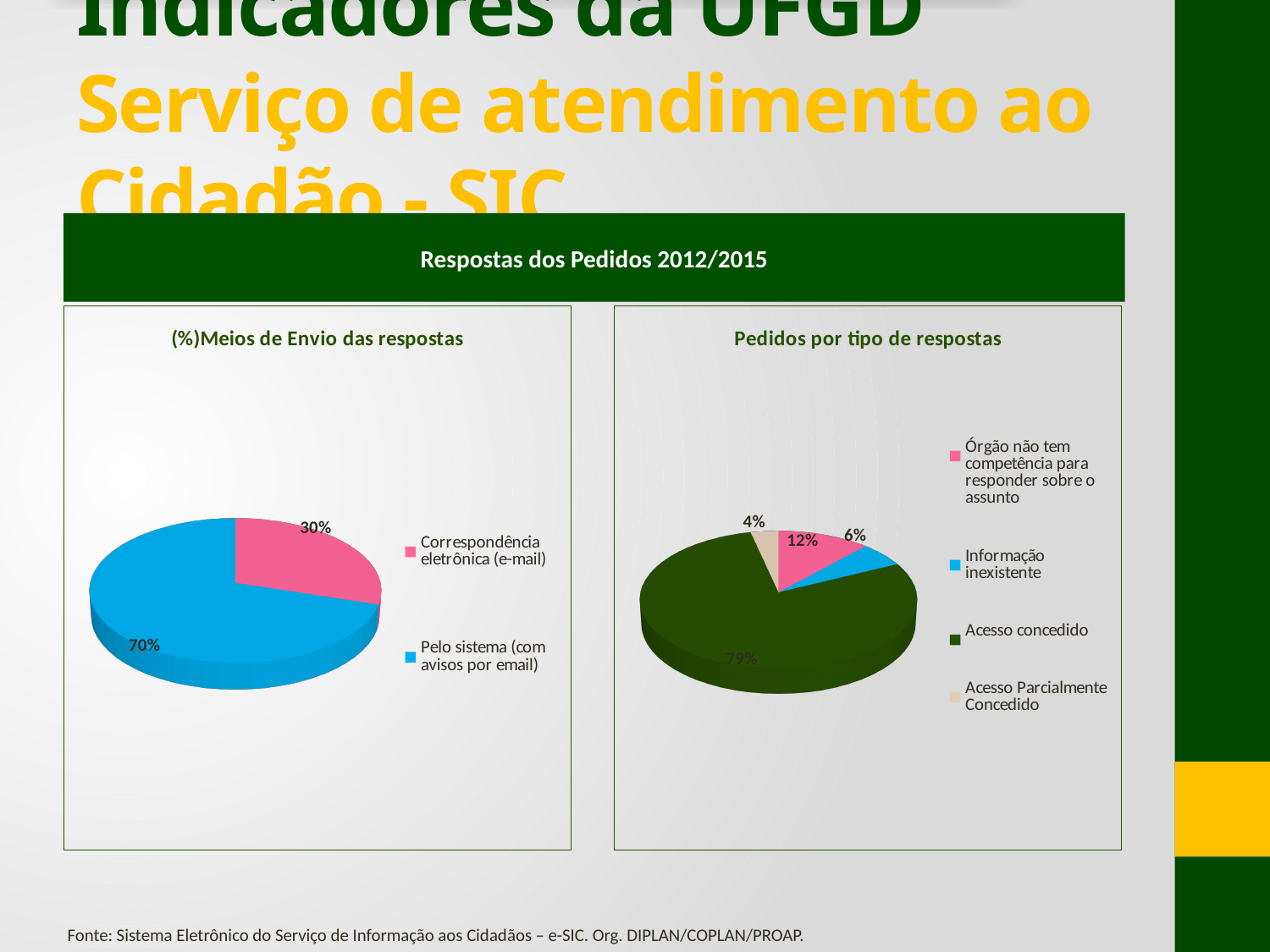
In the chart titled "Pedidos por tipo de respostas", which category has the smallest share? Acesso Parcialmente Concedido In the chart titled "Pedidos por tipo de respostas", what is the value for "Acesso concedido"? 79% In the chart titled "(%)Meios de Envio das respostas", how many categories does the legend list? 2 In the chart titled "(%)Meios de Envio das respostas", what is the value for "Pelo sistema (com avisos por email)"? 70% In the chart titled "Pedidos por tipo de respostas", which is larger: "Órgão não tem competência para responder sobre o assunto" or "Informação inexistente"? Órgão não tem competência para responder sobre o assunto In the chart titled "Pedidos por tipo de respostas", how many categories does the legend list? 4 In the chart titled "(%)Meios de Envio das respostas", what is the difference between the two slices? 40% In the chart titled "(%)Meios de Envio das respostas", which category has the largest share? Pelo sistema (com avisos por email) What kind of chart is the chart titled "Pedidos por tipo de respostas"? Pie chart In the chart titled "(%)Meios de Envio das respostas", what is the value for "Correspondência eletrônica (e-mail)"? 30% In the chart titled "Pedidos por tipo de respostas", what colour is the slice for "Acesso concedido"? Dark green In the chart titled "Pedidos por tipo de respostas", what is the value for "Informação inexistente"? 6%